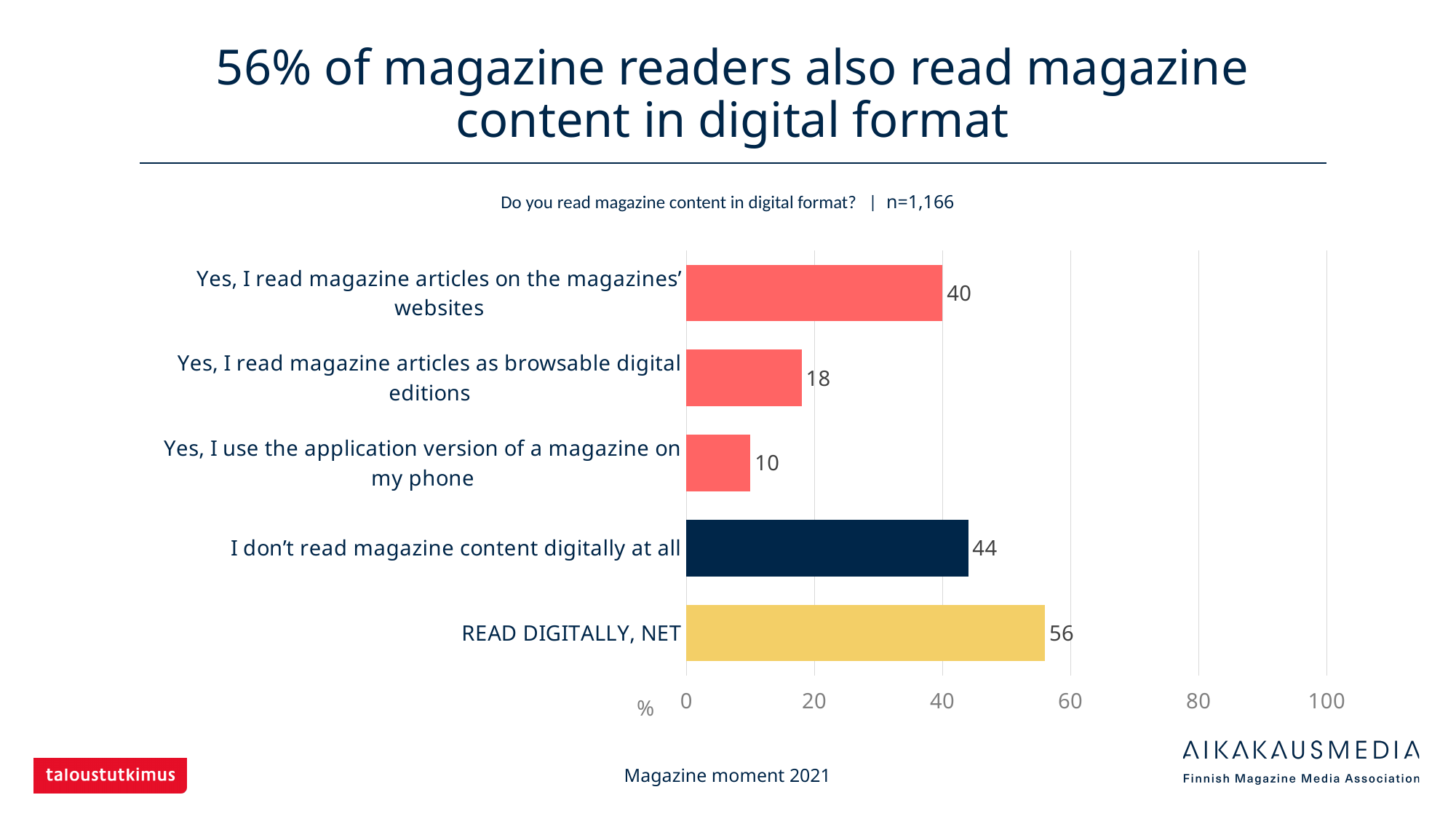
Which category has the lowest value? Yes, I use the application version of a magazine on my phone Which category has the highest value? READ DIGITALLY, NET How many categories are shown in the chart? 5 What is the sample size (n) stated above the chart? n=1,166 What kind of chart is shown on the slide? Bar chart What is the value for "READ DIGITALLY, NET"? 56 What is the value for "I don't read magazine content digitally at all"? 44 What is the value for "Yes, I read magazine articles as browsable digital editions"? 18 What is the value for "Yes, I use the application version of a magazine on my phone"? 10 Which is larger: the value for "Yes, I read magazine articles as browsable digital editions" or the value for "Yes, I use the application version of a magazine on my phone"? Yes, I read magazine articles as browsable digital editions What is the value for "Yes, I read magazine articles on the magazines' websites"? 40 What is the difference between the value for "I don't read magazine content digitally at all" and the value for "Yes, I read magazine articles on the magazines' websites"? 4